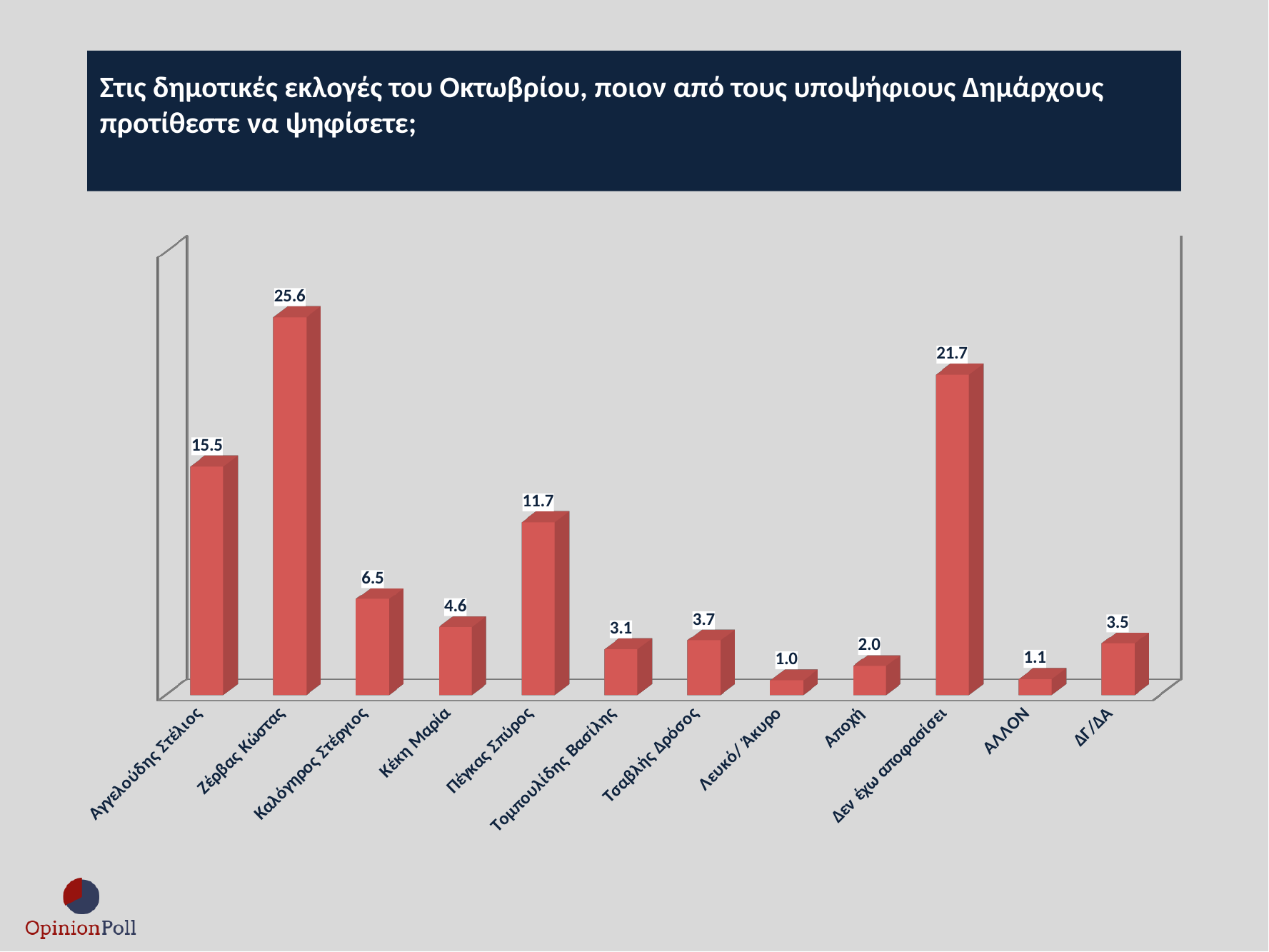
Which is larger, the value for Καλόγηρος Στέργιος or the value for Τσαβλής Δρόσος? Καλόγηρος Στέργιος How many categories are shown in the chart? 12 What is the value for Ζέρβας Κώστας? 25.6 What is the value for Κέκη Μαρία? 4.6 What is the difference between the values for Δεν έχω αποφασίσει and Πέγκας Σπύρος? 10.0 What is the difference between the values for Ζέρβας Κώστας and Αγγελούδης Στέλιος? 10.1 What is the value for Δεν έχω αποφασίσει? 21.7 What kind of chart is shown on the slide? Bar chart What is the value for Αγγελούδης Στέλιος? 15.5 Which category has the lowest value? Λευκό/ Άκυρο What is the value for Πέγκας Σπύρος? 11.7 Which category has the highest value? Ζέρβας Κώστας